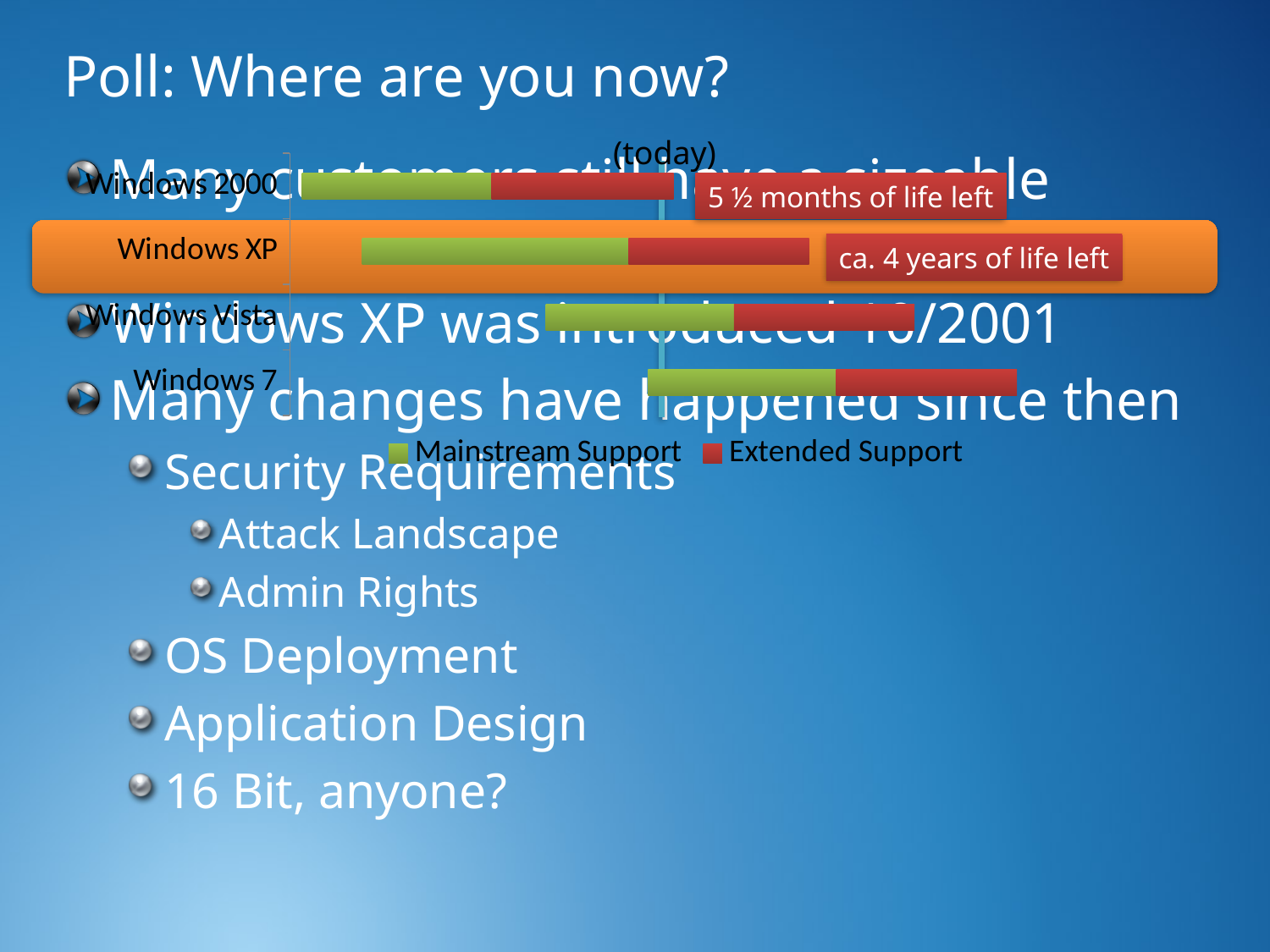
Which Windows version's bar starts furthest to the right in the chart? Windows 7 How many series does the chart legend list? 2 What kind of chart is shown on the slide? Stacked horizontal bar chart Which Windows version's bar ends earliest (furthest left) in the chart? Windows 2000 Do the bars start progressively later moving down the chart from Windows 2000 to Windows 7? Yes Which colour represents Extended Support in the chart? Red According to the annotation on the chart, how much life is left for Windows 2000? 5 ½ months of life left Which Windows version's bar starts furthest to the left in the chart? Windows 2000 Which Windows version's bar extends furthest to the right in the chart? Windows 7 What are the two series named in the chart legend? Mainstream Support and Extended Support According to the annotation on the chart, how much life is left for Windows XP? ca. 4 years of life left How many Windows versions (categories) are plotted in the chart? 4